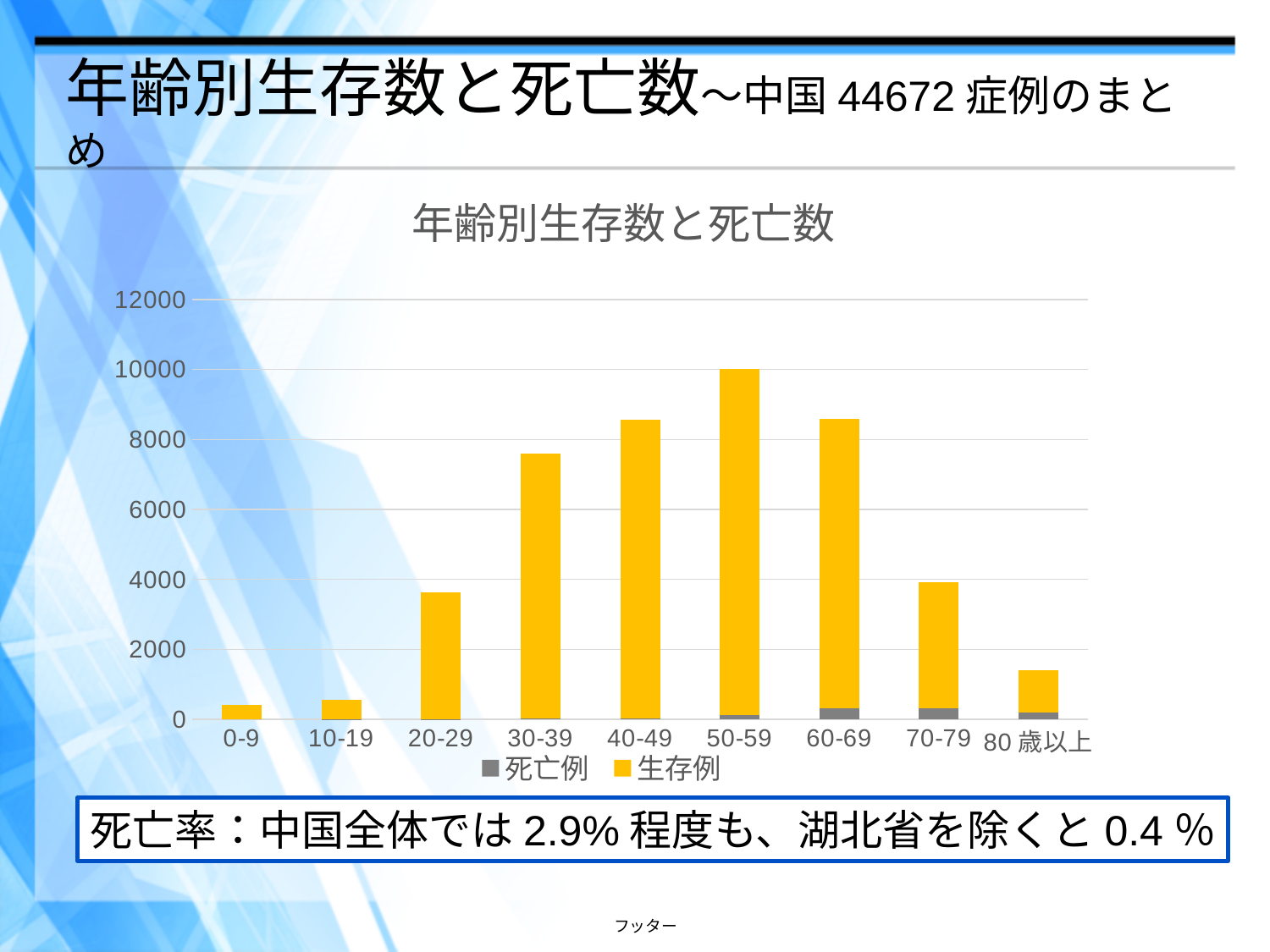
How many age categories are shown on the x axis? 9 What kind of chart is shown on the slide? bar chart Which age category has the tallest bar? 50-59 Is the total bar for 30-39 greater or less than 6000? greater Which bar is taller, 30-39 or 70-79? 30-39 Which bar is taller, 0-9 or 80歳以上? 80歳以上 Do the bar heights rise or fall from 50-59 to 80歳以上? fall Is the total bar for 80歳以上 greater or less than 2000? less What is the title of the chart? 年齢別生存数と死亡数 Is the total bar for 20-29 greater or less than 4000? less How many series does the legend list? 2